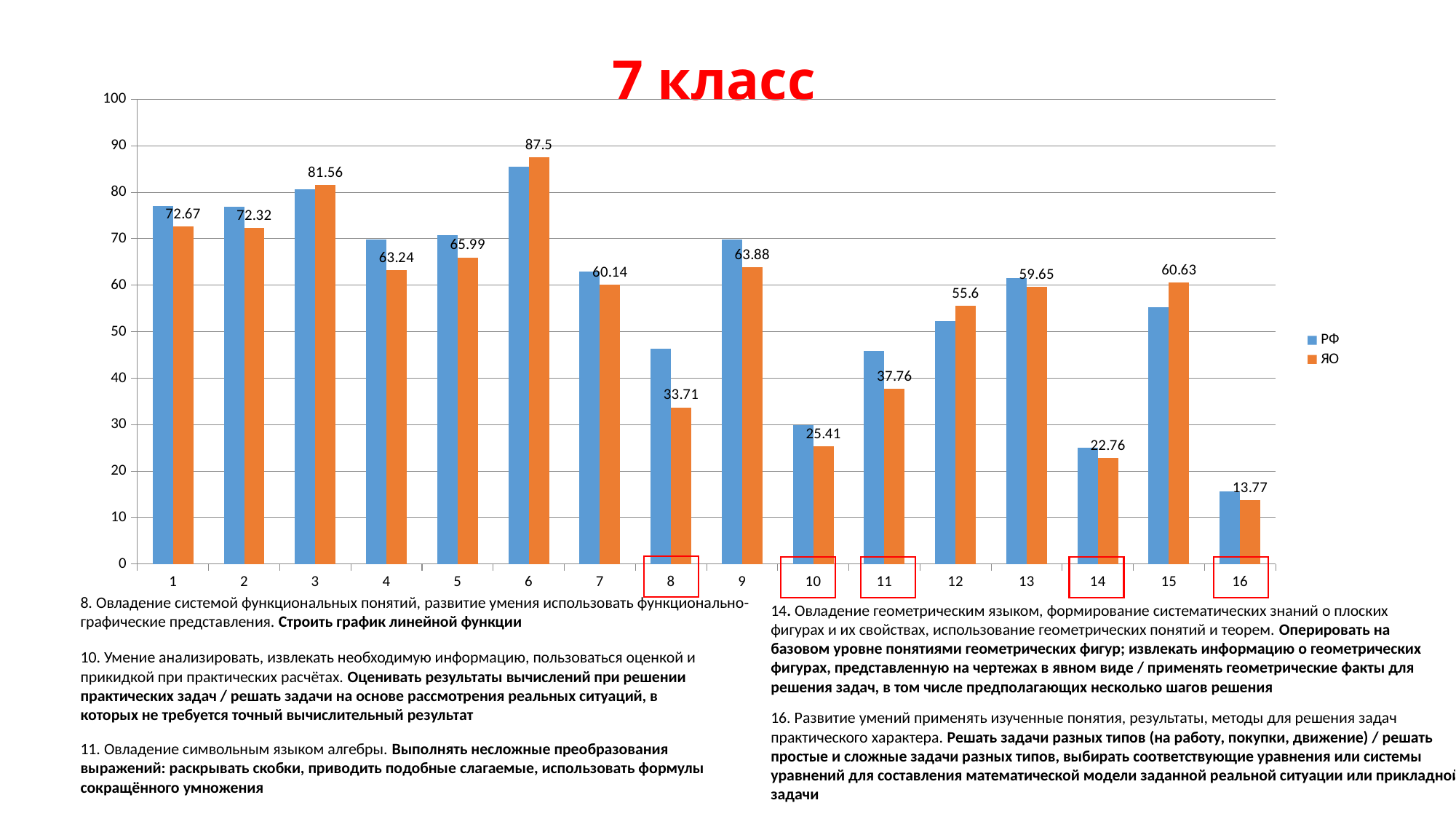
For category 15, which series has the larger value, РФ or ЯО? ЯО Which category has the highest ЯО value? 6 What is the title of the chart? 7 класс What is the ЯО value for category 16? 13.77 What is the ЯО value for category 6? 87.5 How many series does the legend list? 2 What is the ЯО value for category 8? 33.71 For category 8, which series has the larger value, РФ or ЯО? РФ Is the РФ value for category 8 greater or less than 40? greater How many categories are shown on the x axis? 16 What is the difference between the ЯО values for category 6 and category 16? 73.73 Which category has the lowest ЯО value? 16